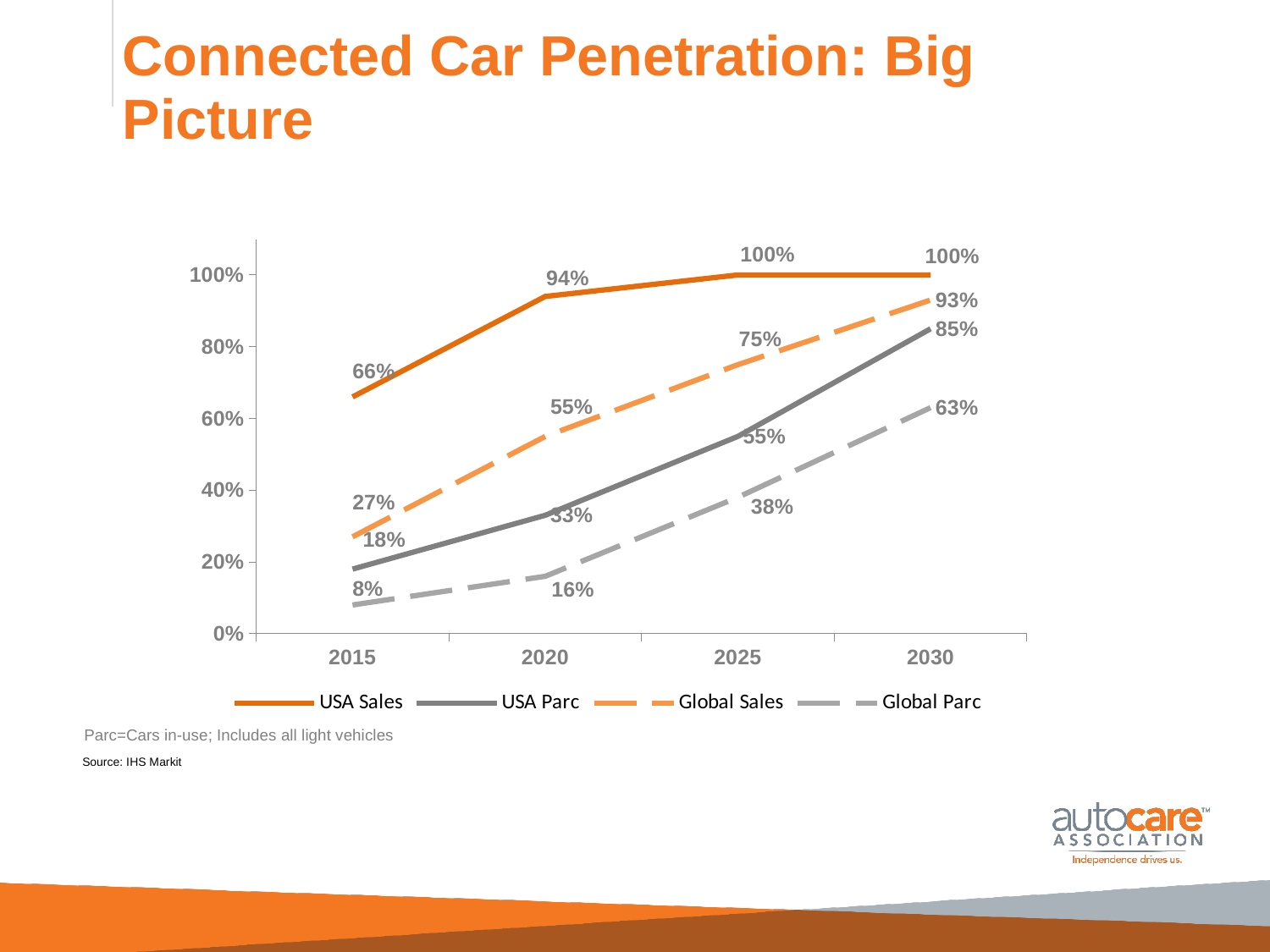
What is the difference between Global Sales and USA Parc in 2030? 8% Which series has the lowest value in 2015? Global Parc Which is larger in 2020: Global Sales or USA Parc? Global Sales What is the value for USA Parc in 2015? 18% What is the value for USA Sales in 2020? 94% How many years are shown on the x axis? 4 Which series has the highest value in 2030? USA Sales What is the value for Global Parc in 2030? 63% Does the USA Parc series rise or fall from 2015 to 2030? Rise How many series does the legend list? 4 What is the value for Global Sales in 2025? 75% What type of chart is shown on the slide? Line chart